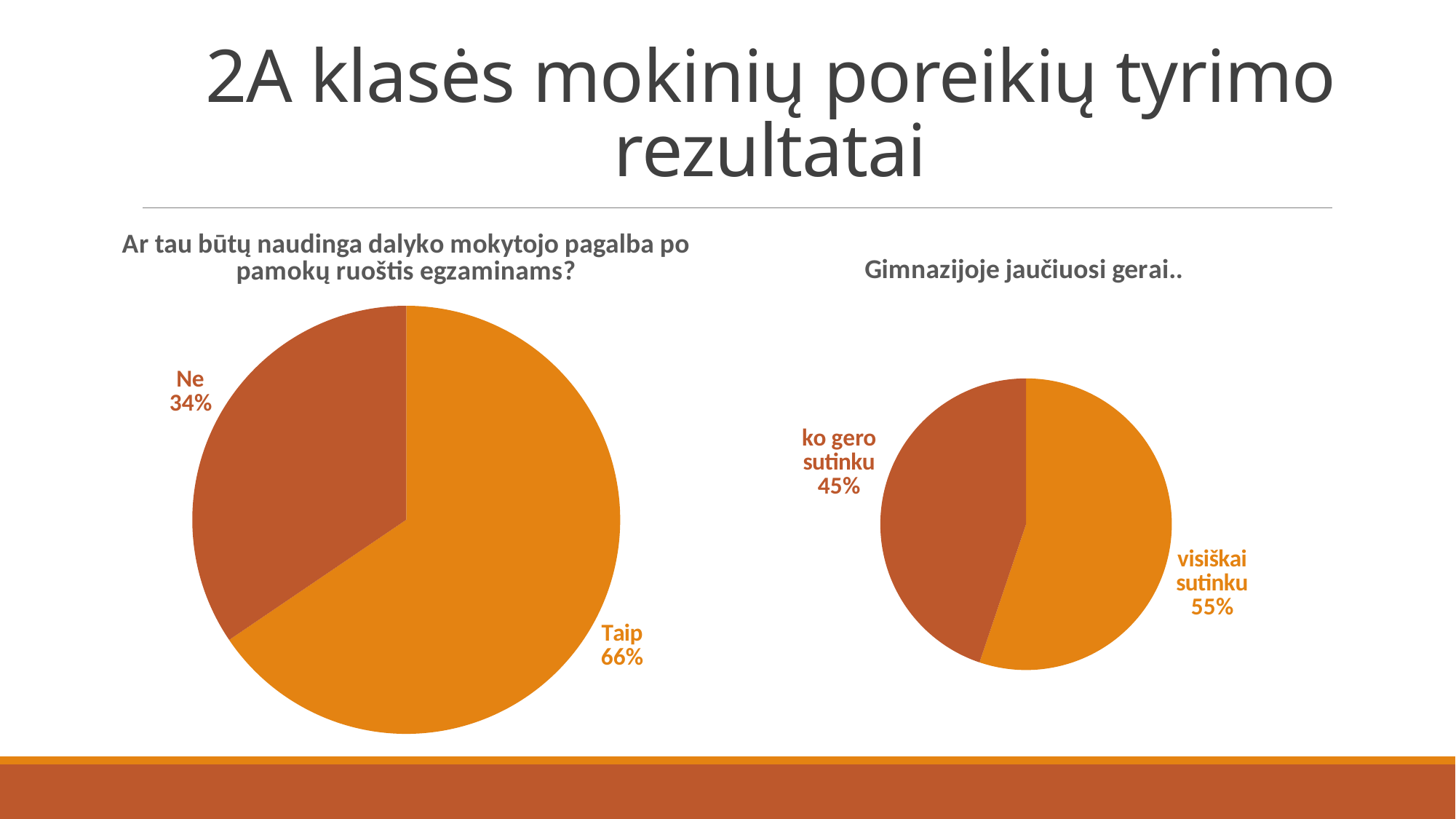
In the left pie chart, what share is labelled "Ne"? 34% How many slices does the left pie chart have? 2 What type of chart is the chart on the right of the slide? Pie chart In the right pie chart, which slice is the smallest? ko gero sutinku In the right pie chart, which is larger: "visiškai sutinku" or "ko gero sutinku"? visiškai sutinku What is the title of the chart on the right of the slide? Gimnazijoje jaučiuosi gerai.. In the right pie chart, what share is labelled "ko gero sutinku"? 45% In the right pie chart, what is the difference between the "visiškai sutinku" and "ko gero sutinku" shares? 10% In the left pie chart, what is the difference between the "Taip" and "Ne" shares? 32% In the left pie chart ("Ar tau būtų naudinga dalyko mokytojo pagalba po pamokų ruoštis egzaminams?"), what share is labelled "Taip"? 66% In the right pie chart ("Gimnazijoje jaučiuosi gerai.."), what share is labelled "visiškai sutinku"? 55% In the left pie chart, which slice is the largest? Taip